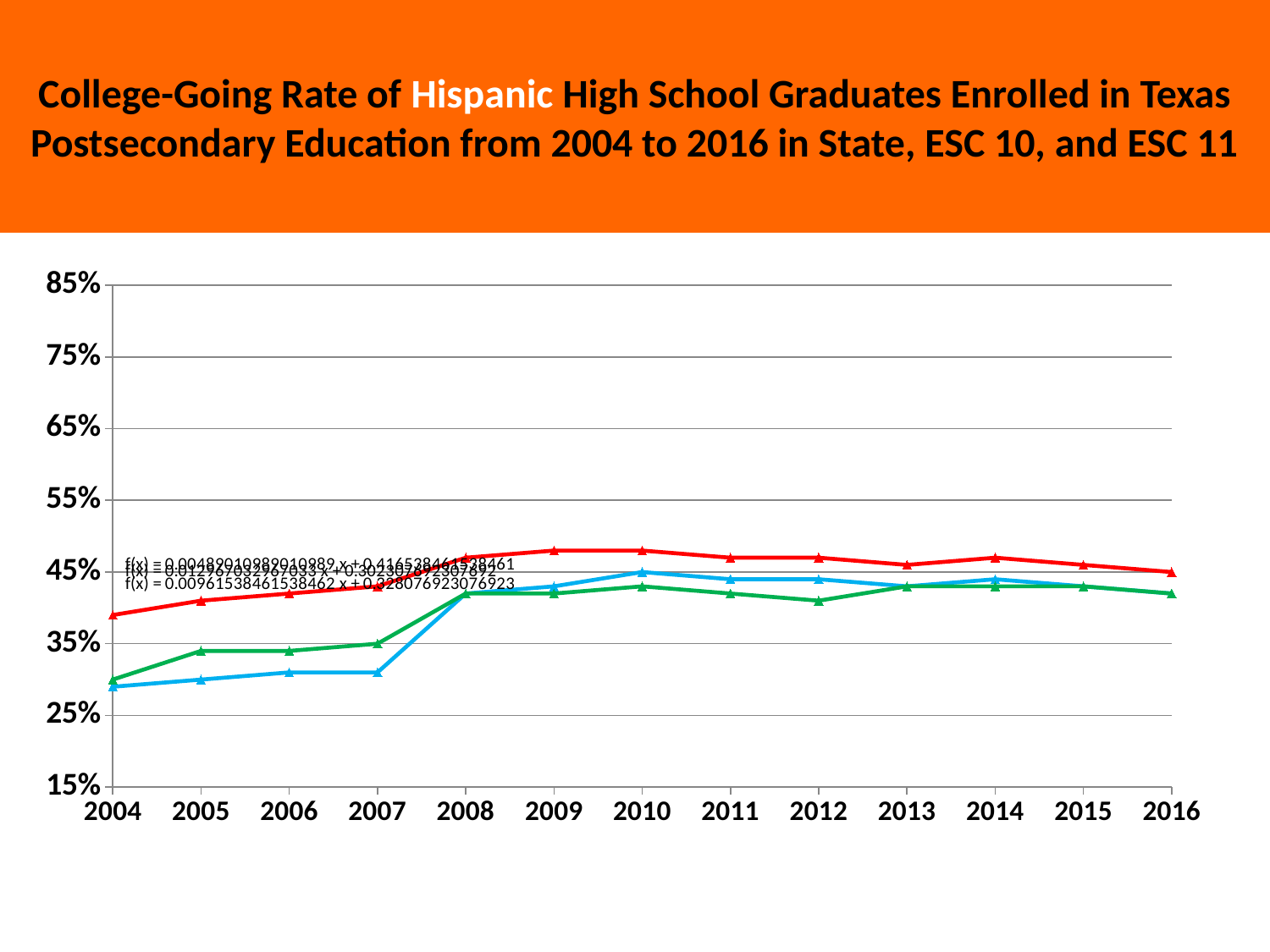
How many lines are plotted on the chart? 3 Does the blue line rise or fall from 2004 to 2010? rise What is the highest value shown on the y axis? 85% Is the value of the green line in 2012 greater or less than 45%? less In which year is the red line at its lowest value? 2004 Is the value of the red line in 2004 greater or less than 45%? less In 2005, which line has the higher value, the green line or the blue line? green line Is the value of the red line in 2009 greater or less than 45%? greater In 2004, which line has the higher value, the red line or the blue line? red line What kind of chart is shown on the slide? line chart How many years are plotted along the x axis? 13